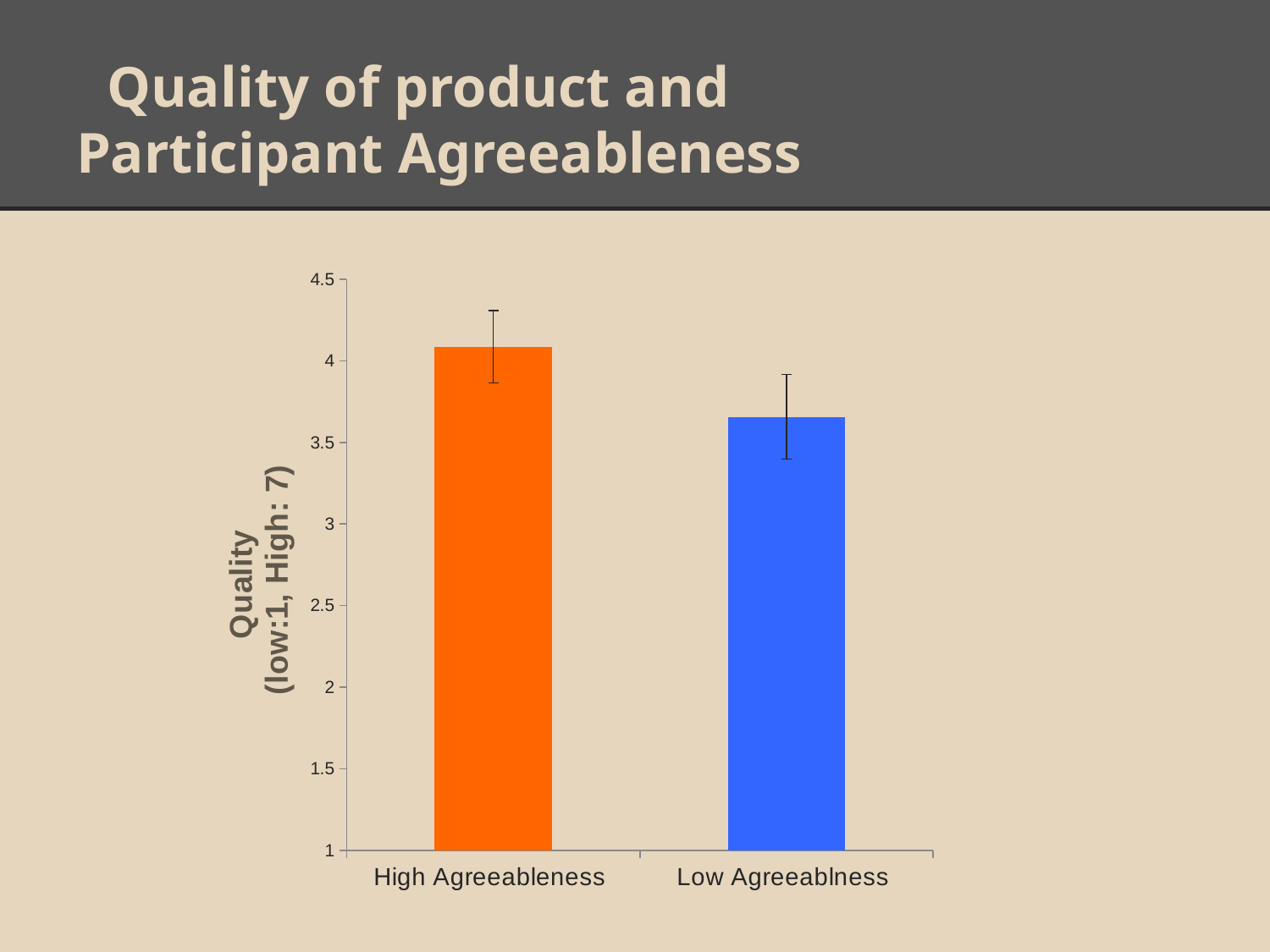
Is the value for High Agreeableness greater or less than 4.5? less Is the value for Low Agreeablness greater or less than 3.5? greater Is the value for Low Agreeablness greater or less than 4? less Which bar is taller, High Agreeableness or Low Agreeablness? High Agreeableness Which category has the highest quality rating? High Agreeableness What colour is the bar for Low Agreeablness? blue What kind of chart is shown on the slide? bar chart What is the label of the y axis? Quality (low:1, High: 7) How many categories are shown on the x axis of the chart? 2 Which category has the lowest quality rating? Low Agreeablness